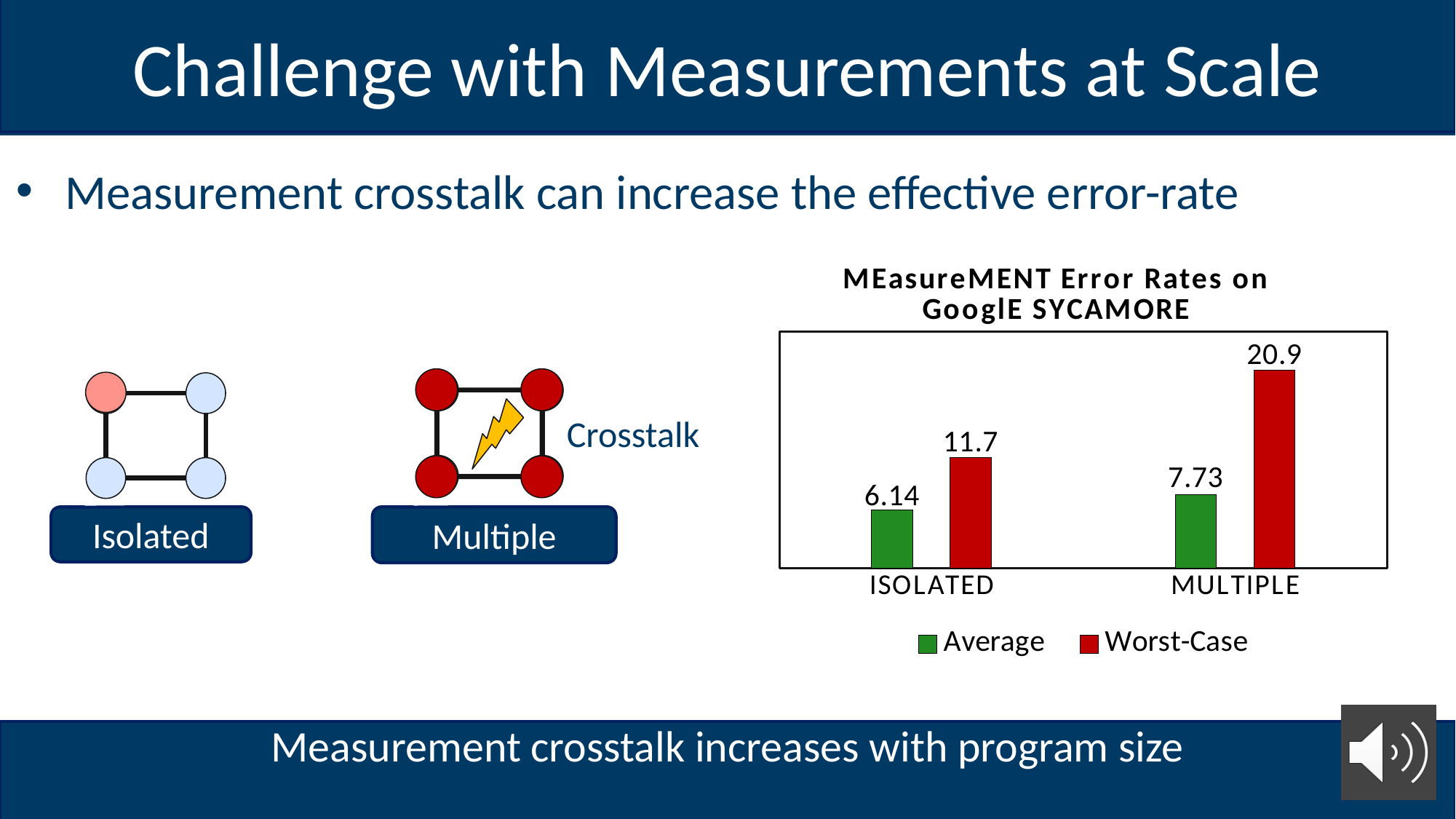
What is the Average measurement error rate for ISOLATED? 6.14 What is the Average measurement error rate for MULTIPLE? 7.73 What is the Worst-Case measurement error rate for MULTIPLE? 20.9 Which category has the lowest Average error rate? ISOLATED What is the difference between the Worst-Case and Average error rates for ISOLATED? 5.56 Which is larger, the Average error rate for MULTIPLE or the Average error rate for ISOLATED? MULTIPLE What is the Worst-Case measurement error rate for ISOLATED? 11.7 How many categories are shown on the x axis of the chart? 2 Which category has the highest Worst-Case error rate? MULTIPLE What is the difference between the Worst-Case error rates for MULTIPLE and ISOLATED? 9.2 How many series does the chart legend list? 2 What type of chart is shown on the slide? Bar chart